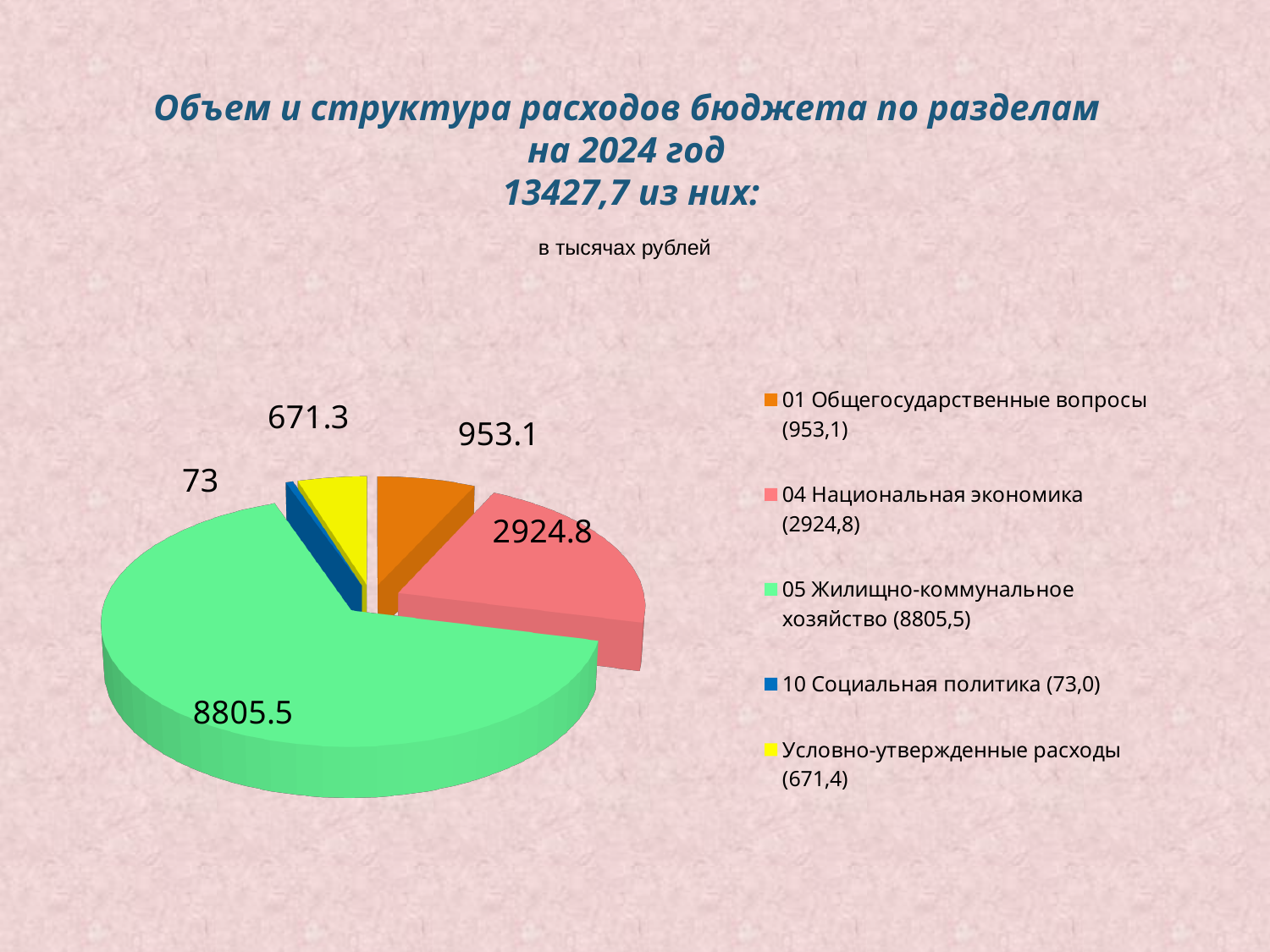
What is the difference between the values for 04 Национальная экономика and 01 Общегосударственные вопросы? 1971.7 Which category has the largest slice of the pie? 05 Жилищно-коммунальное хозяйство What is the value shown for 01 Общегосударственные вопросы? 953.1 Which category has the smallest slice of the pie? 10 Социальная политика Which is larger: 01 Общегосударственные вопросы or 04 Национальная экономика? 04 Национальная экономика What is the value shown for 04 Национальная экономика? 2924.8 What kind of chart is shown on the slide? Pie chart What colour is the slice for 10 Социальная политика? Blue What is the value shown for 05 Жилищно-коммунальное хозяйство? 8805.5 What is the difference between the values for 05 Жилищно-коммунальное хозяйство and 04 Национальная экономика? 5880.7 What is the value shown for 10 Социальная политика? 73 How many slices does the pie chart have? 5